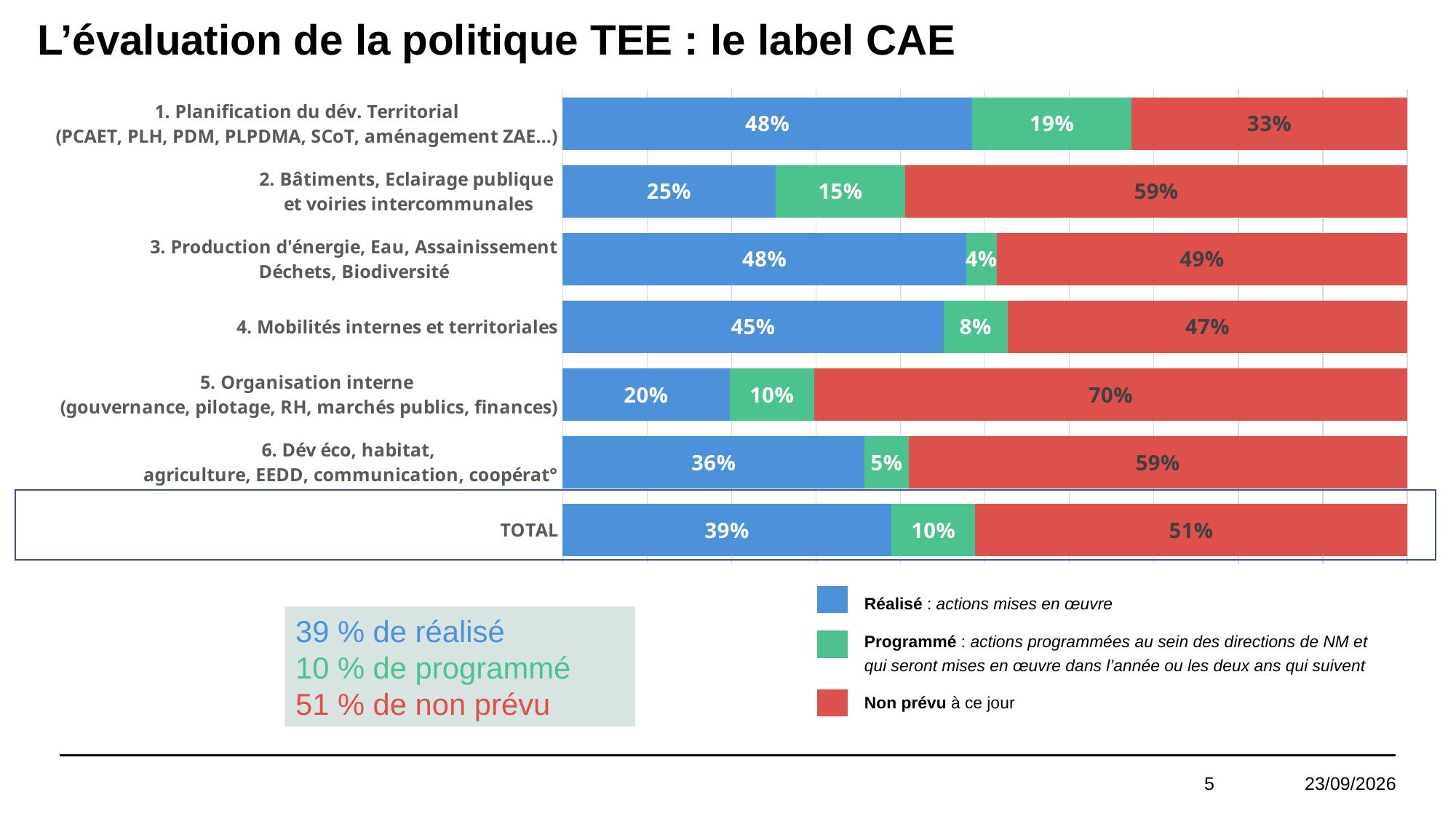
How many series does the legend list? 3 How many bars (categories) are shown in the chart, including TOTAL? 7 What is the Programmé value for "1. Planification du dév. Territorial"? 19% What is the Réalisé value for the TOTAL bar? 39% Which category has the highest Non prévu value? 5. Organisation interne Which category has the lowest Réalisé value? 5. Organisation interne What is the Non prévu value for "5. Organisation interne"? 70% What is the difference between the Non prévu and Réalisé values for "2. Bâtiments, Eclairage publique et voiries intercommunales"? 34 percentage points What kind of chart is shown on the slide? Stacked bar chart What is the Réalisé value for "4. Mobilités internes et territoriales"? 45% Which has the larger Réalisé value: "6. Dév éco, habitat" or "2. Bâtiments, Eclairage publique"? 6. Dév éco, habitat Which category has the highest Programmé value? 1. Planification du dév. Territorial